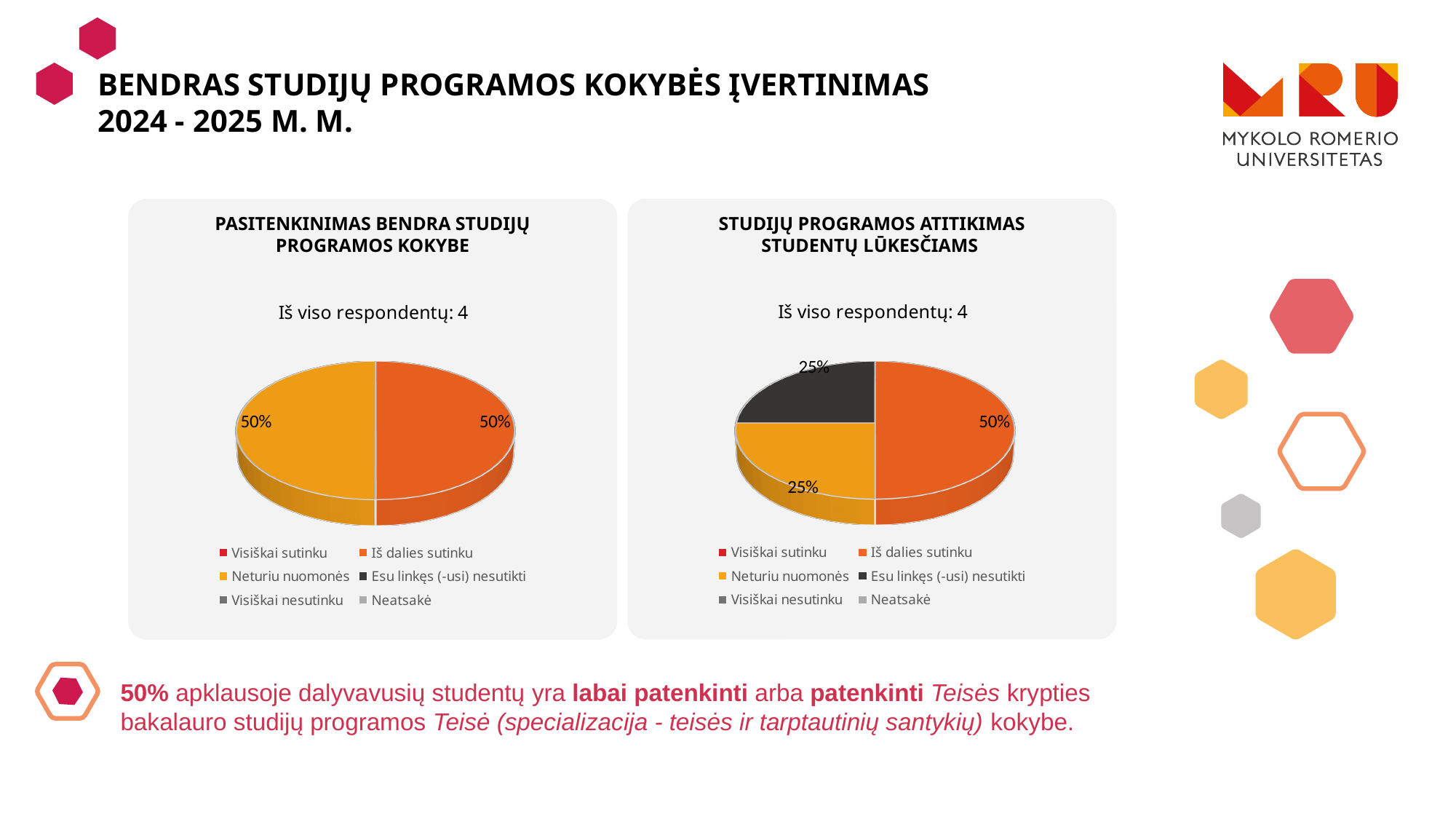
How many respondents are reported for the 'STUDIJŲ PROGRAMOS ATITIKIMAS STUDENTŲ LŪKESČIAMS' chart? 4 In the 'STUDIJŲ PROGRAMOS ATITIKIMAS STUDENTŲ LŪKESČIAMS' chart, what is the difference between the 'Iš dalies sutinku' share and the 'Neturiu nuomonės' share? 25% How many entries does the legend of the 'PASITENKINIMAS BENDRA STUDIJŲ PROGRAMOS KOKYBE' chart list? 6 In the 'PASITENKINIMAS BENDRA STUDIJŲ PROGRAMOS KOKYBE' chart, what share is labelled for 'Iš dalies sutinku'? 50% How many slices does the 'STUDIJŲ PROGRAMOS ATITIKIMAS STUDENTŲ LŪKESČIAMS' pie chart have? 3 In the 'STUDIJŲ PROGRAMOS ATITIKIMAS STUDENTŲ LŪKESČIAMS' chart, which category has the largest slice? Iš dalies sutinku In the 'STUDIJŲ PROGRAMOS ATITIKIMAS STUDENTŲ LŪKESČIAMS' chart, what share is labelled for 'Iš dalies sutinku'? 50% In the 'STUDIJŲ PROGRAMOS ATITIKIMAS STUDENTŲ LŪKESČIAMS' chart, which is larger: 'Iš dalies sutinku' or 'Esu linkęs (-usi) nesutikti'? Iš dalies sutinku What kind of chart is used in the 'PASITENKINIMAS BENDRA STUDIJŲ PROGRAMOS KOKYBE' panel? Pie chart In the 'PASITENKINIMAS BENDRA STUDIJŲ PROGRAMOS KOKYBE' chart, what share is labelled for 'Neturiu nuomonės'? 50% How many slices does the 'PASITENKINIMAS BENDRA STUDIJŲ PROGRAMOS KOKYBE' pie chart have? 2